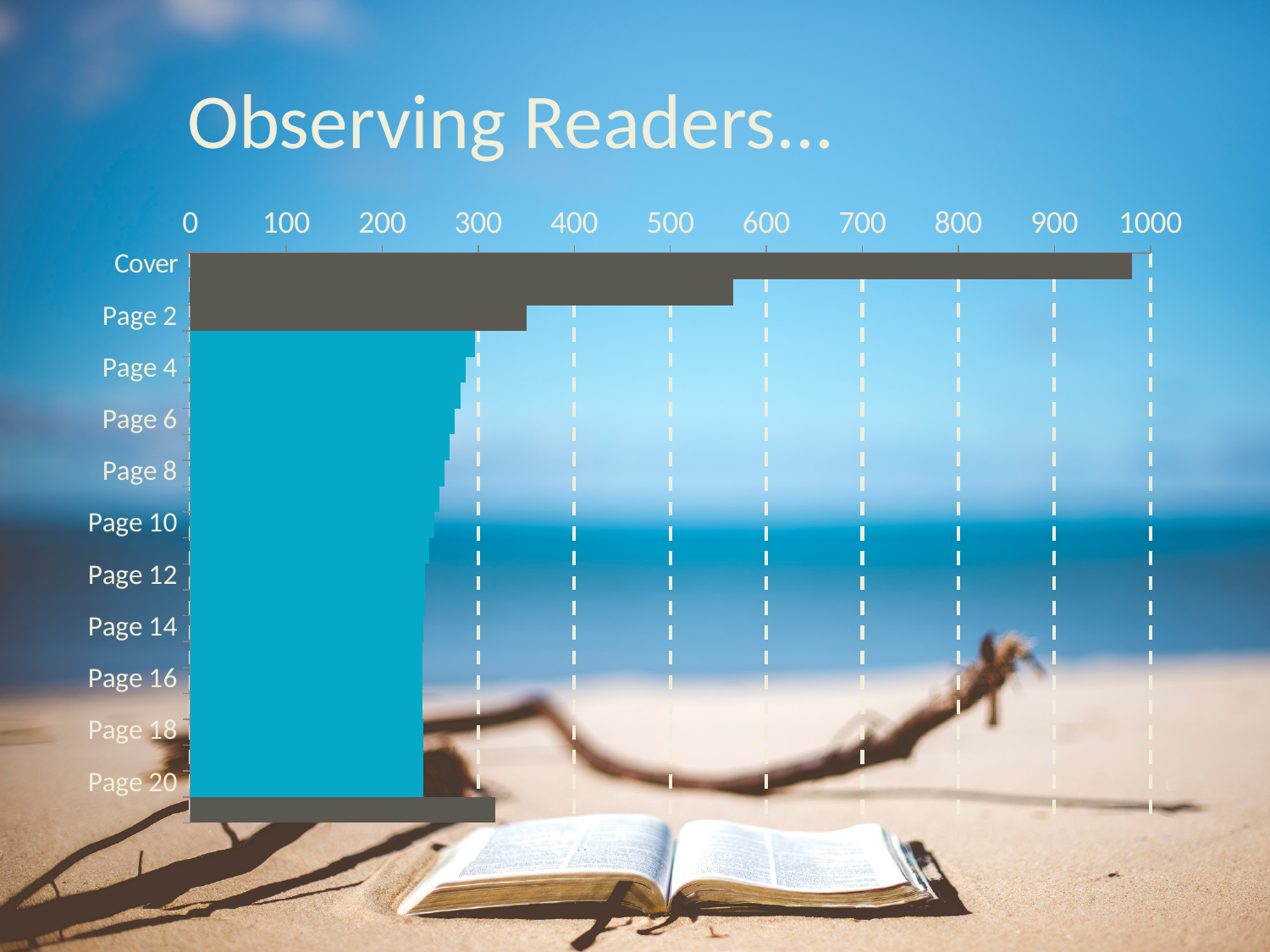
Which is larger, the value for Cover or the value for Page 2? Cover Is the value for Page 20 greater or less than 200? greater Is the value for Page 2 greater or less than 300? greater What is the title of the chart? Observing Readers… Is the value for Page 10 greater or less than 300? less Which is larger, the value for Page 2 or the value for Page 4? Page 2 Which category has the highest value? Cover Do the values generally rise or fall going from Cover down to Page 20? fall What kind of chart is shown on the slide? bar chart